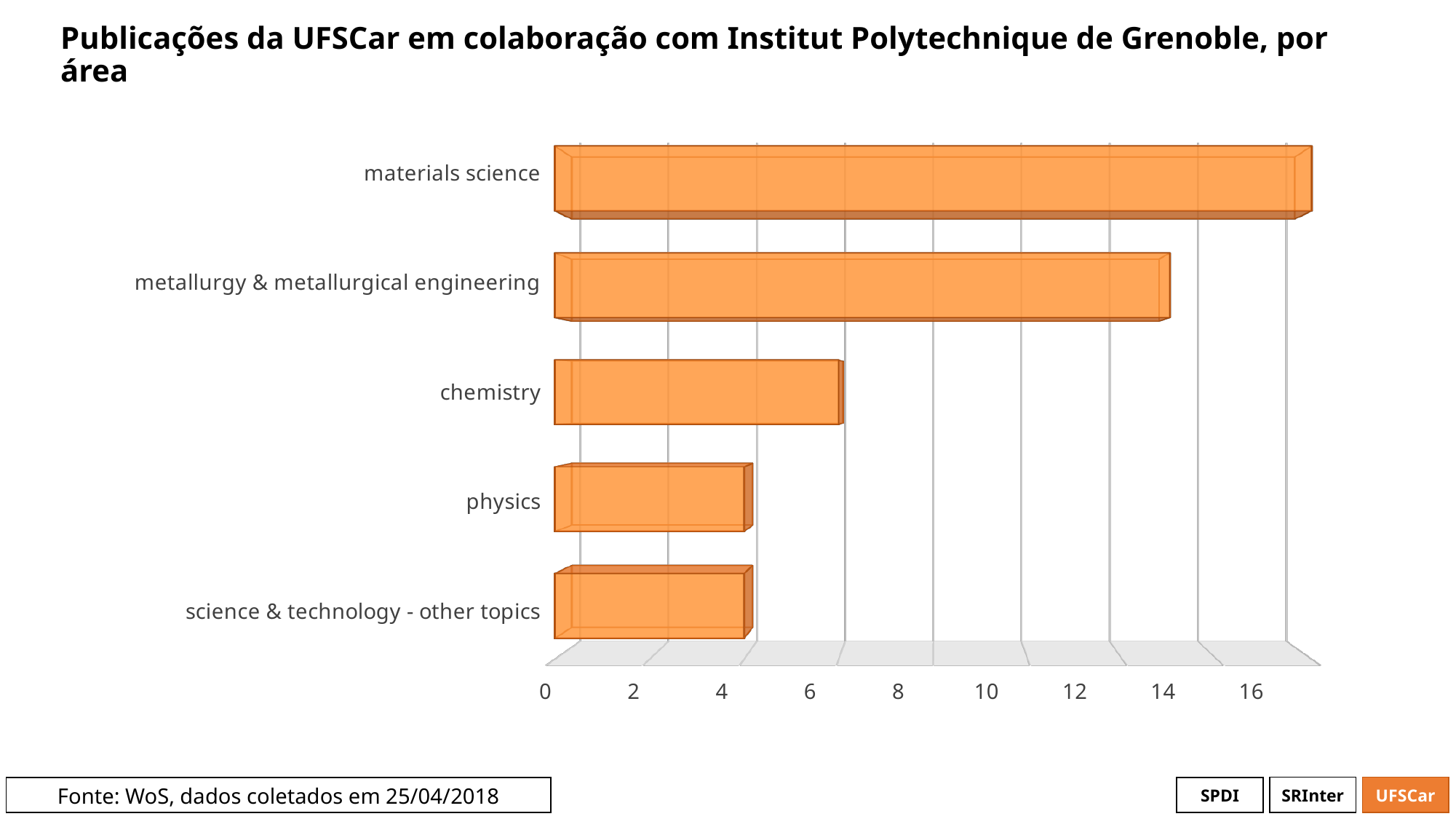
Is the value for metallurgy & metallurgical engineering greater or less than 12? greater What kind of chart is shown on the slide? bar chart Is the value for physics greater or less than 6? less Is the value for chemistry greater or less than 8? less What is the data source cited on the slide? WoS, dados coletados em 25/04/2018 Which has more publications, metallurgy & metallurgical engineering or physics? metallurgy & metallurgical engineering What is the title of the chart? Publicações da UFSCar em colaboração com Institut Polytechnique de Grenoble, por área Which area has the highest number of publications? materials science How many areas (categories) are plotted in the chart? 5 Which has more publications, materials science or chemistry? materials science